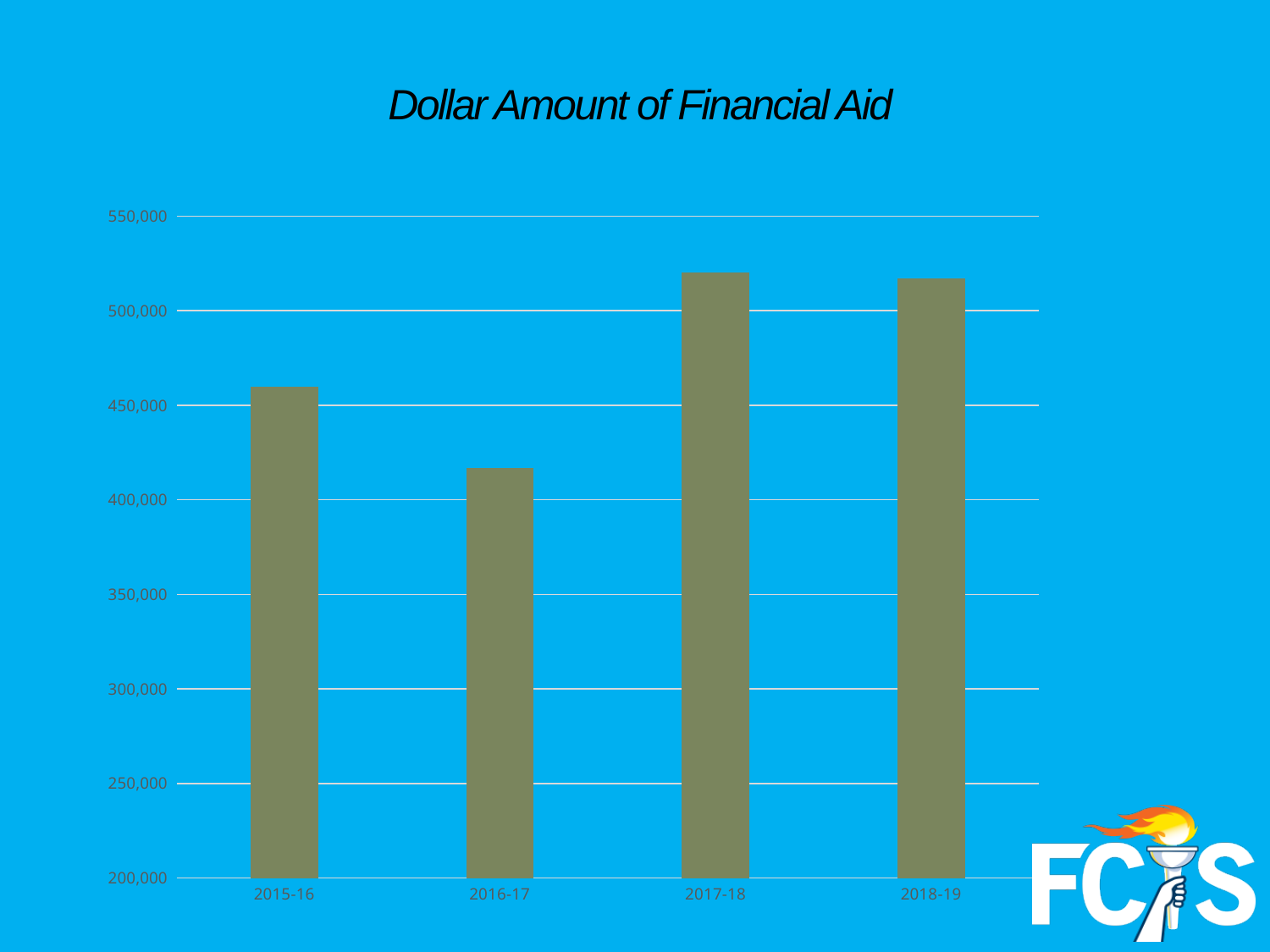
What kind of chart is shown on the slide? bar chart Is the value for 2015-16 greater or less than 500,000? less Is the value for 2018-19 greater or less than 500,000? greater Does the value rise or fall from 2016-17 to 2017-18? rise How many academic years are shown on the x axis of the chart? 4 Is the value for 2017-18 greater or less than 500,000? greater What is the title of the chart? Dollar Amount of Financial Aid Which is larger, the value for 2015-16 or the value for 2016-17? 2015-16 Which academic year has the lowest dollar amount of financial aid? 2016-17